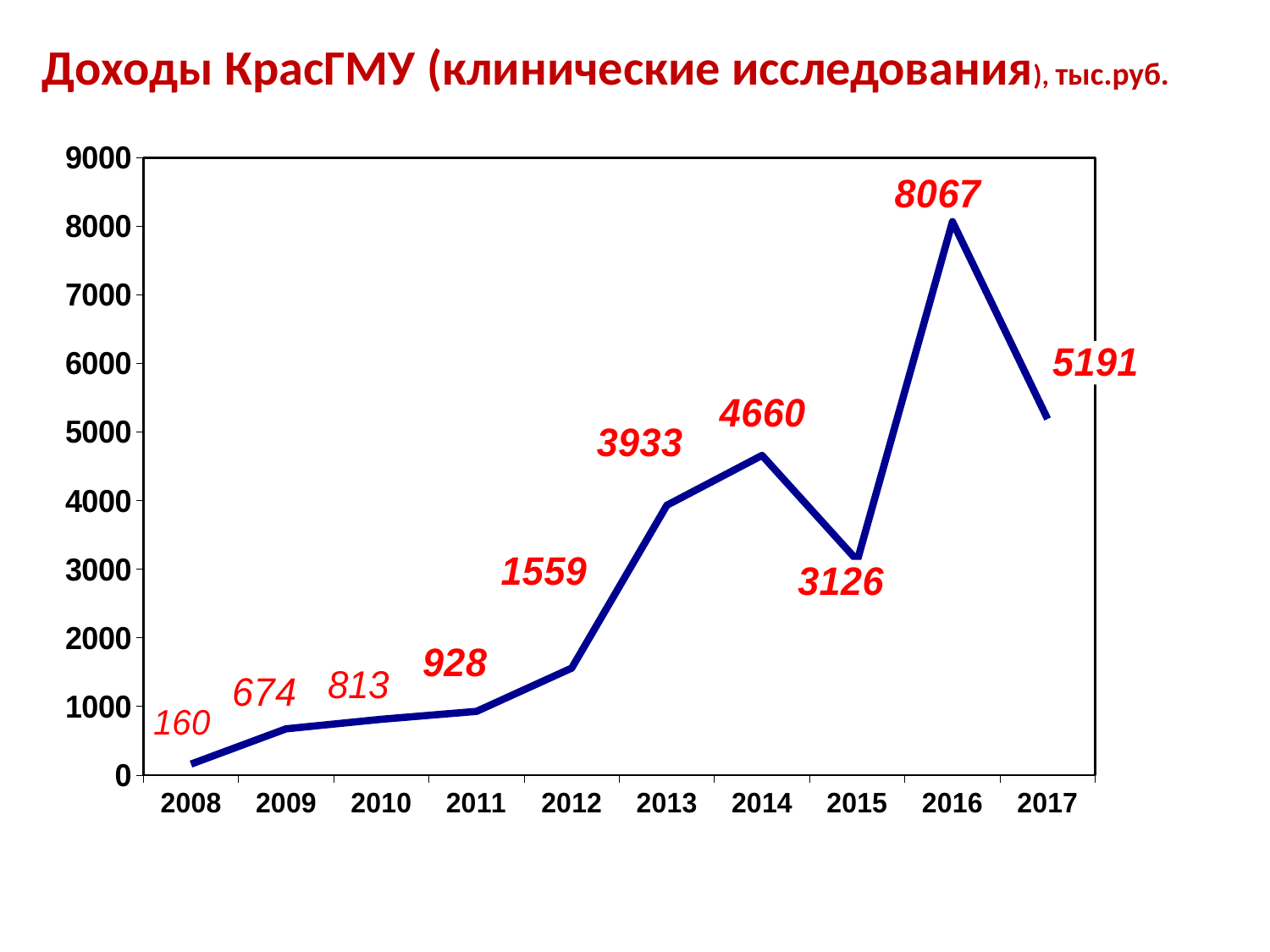
What is the value for 2008? 160 How many years are plotted on the chart? 10 Which year has the highest value? 2016 Is the value for 2012 greater or less than 2000? less What kind of chart is shown on the slide? line chart Which is larger, the value for 2013 or the value for 2015? 2013 Do the values rise or fall from 2008 to 2014? rise What is the difference between the values for 2016 and 2017? 2876 What is the value for 2016? 8067 Which year has the lowest value? 2008 What is the value for 2013? 3933 What is the difference between the values for 2014 and 2015? 1534